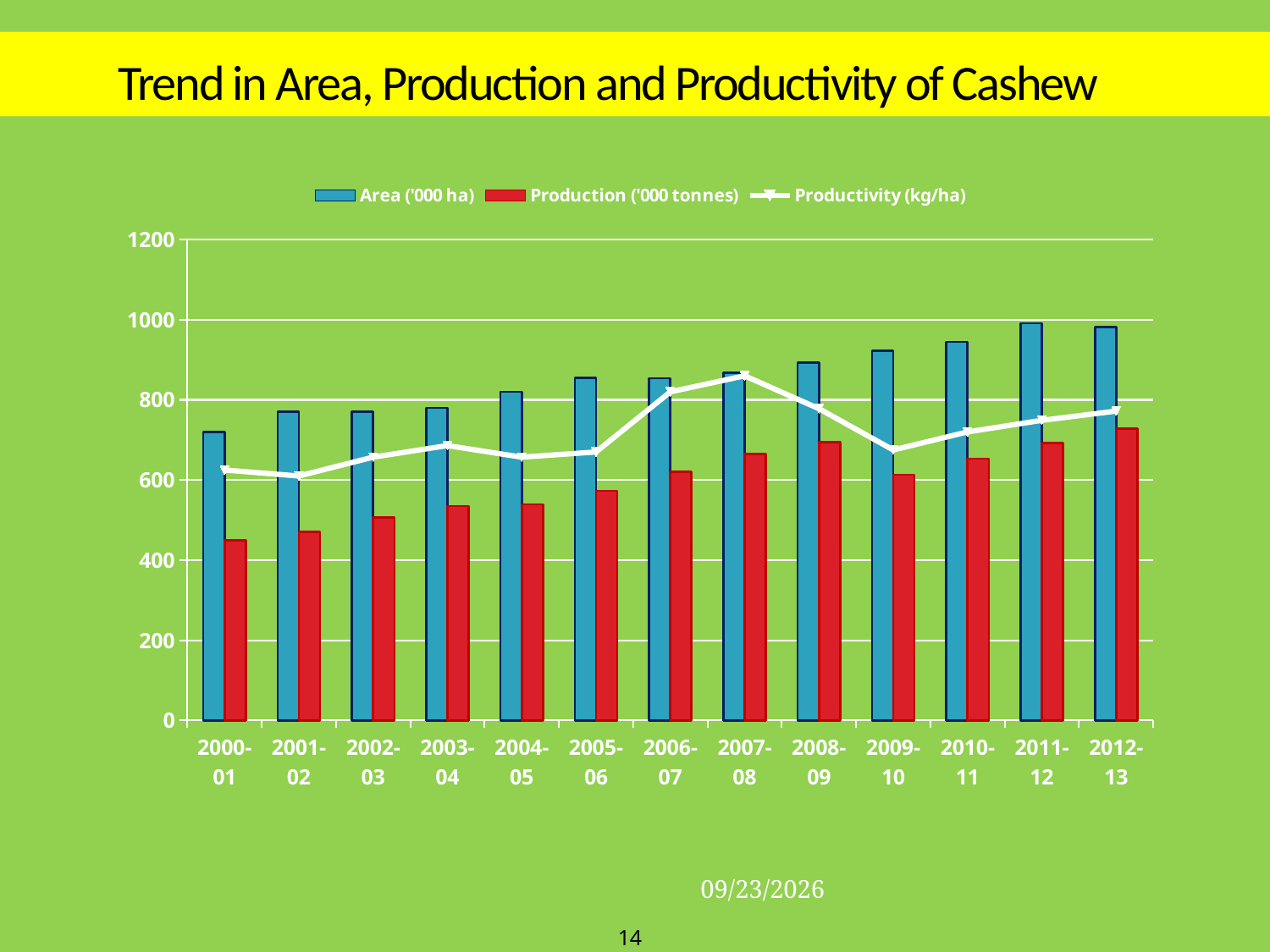
Is the Area ('000 ha) value for 2009-10 greater or less than 800? greater Does Area ('000 ha) generally rise or fall from 2000-01 to 2012-13? rise How many years are shown on the x axis? 13 Which is larger for 2008-09: Area ('000 ha) or Production ('000 tonnes)? Area ('000 ha) Is the Productivity (kg/ha) value for 2009-10 greater or less than 800? less Is the Production ('000 tonnes) value for 2012-13 greater or less than 600? greater Which year has the lowest Production ('000 tonnes)? 2000-01 Which year has the lowest Area ('000 ha)? 2000-01 What kind of chart is this? Bar chart with a line series Which year has the highest Productivity (kg/ha)? 2007-08 How many series does the legend list? 3